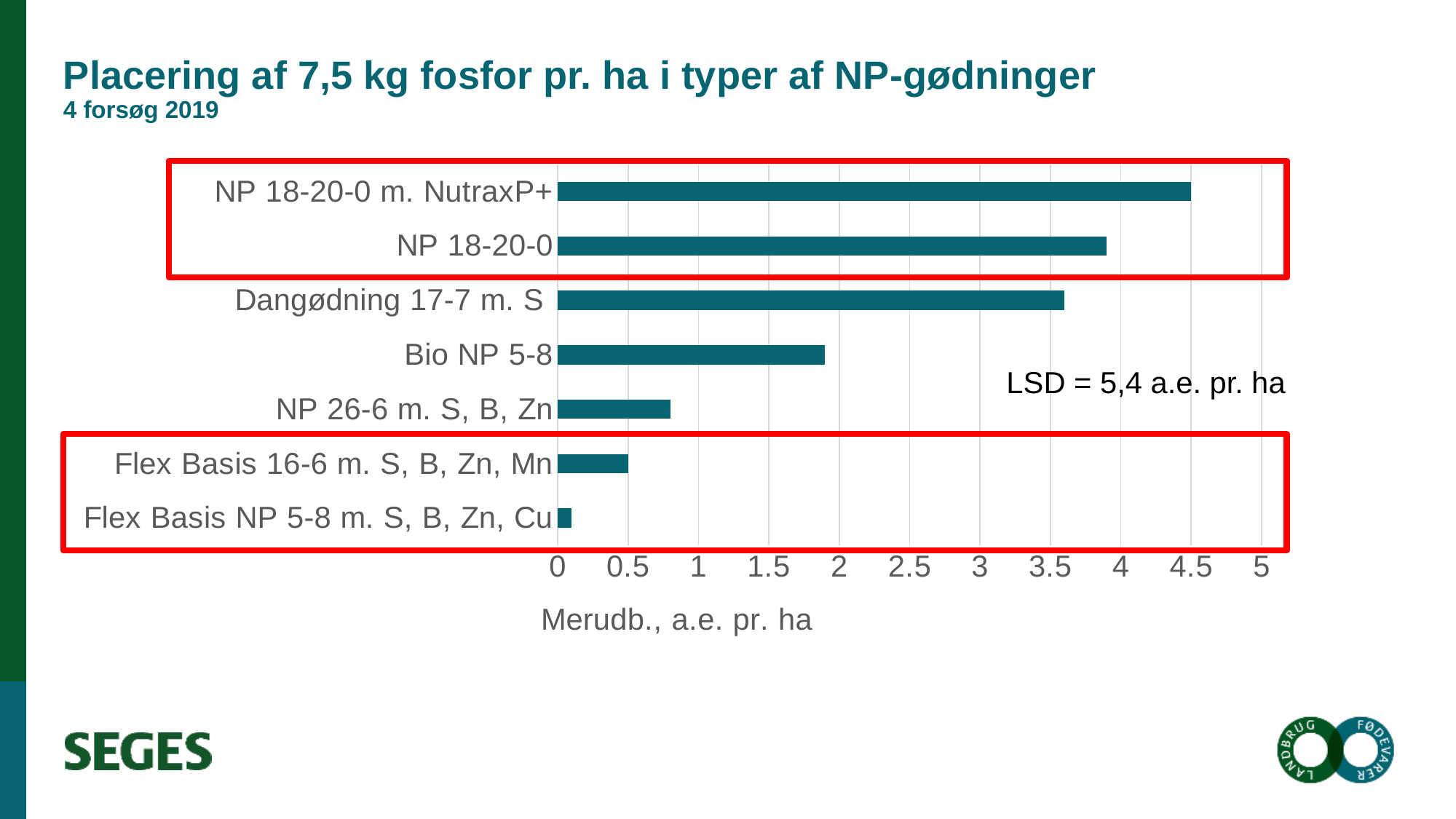
What kind of chart is shown on the slide? bar chart What is the label of the x axis? Merudb., a.e. pr. ha Which has the larger value: NP 18-20-0 or Dangødning 17-7 m. S? NP 18-20-0 Is the value for Dangødning 17-7 m. S greater or less than 3? greater Which fertiliser type has the highest Merudb., a.e. pr. ha? NP 18-20-0 m. NutraxP+ Is the value for NP 26-6 m. S, B, Zn greater or less than 1? less Which has the larger value: Bio NP 5-8 or NP 26-6 m. S, B, Zn? Bio NP 5-8 Is the value for NP 18-20-0 m. NutraxP+ greater or less than 4? greater What LSD value is stated on the chart? LSD = 5,4 a.e. pr. ha How many fertiliser types (categories) are plotted in the chart? 7 Which fertiliser type has the lowest Merudb., a.e. pr. ha? Flex Basis NP 5-8 m. S, B, Zn, Cu